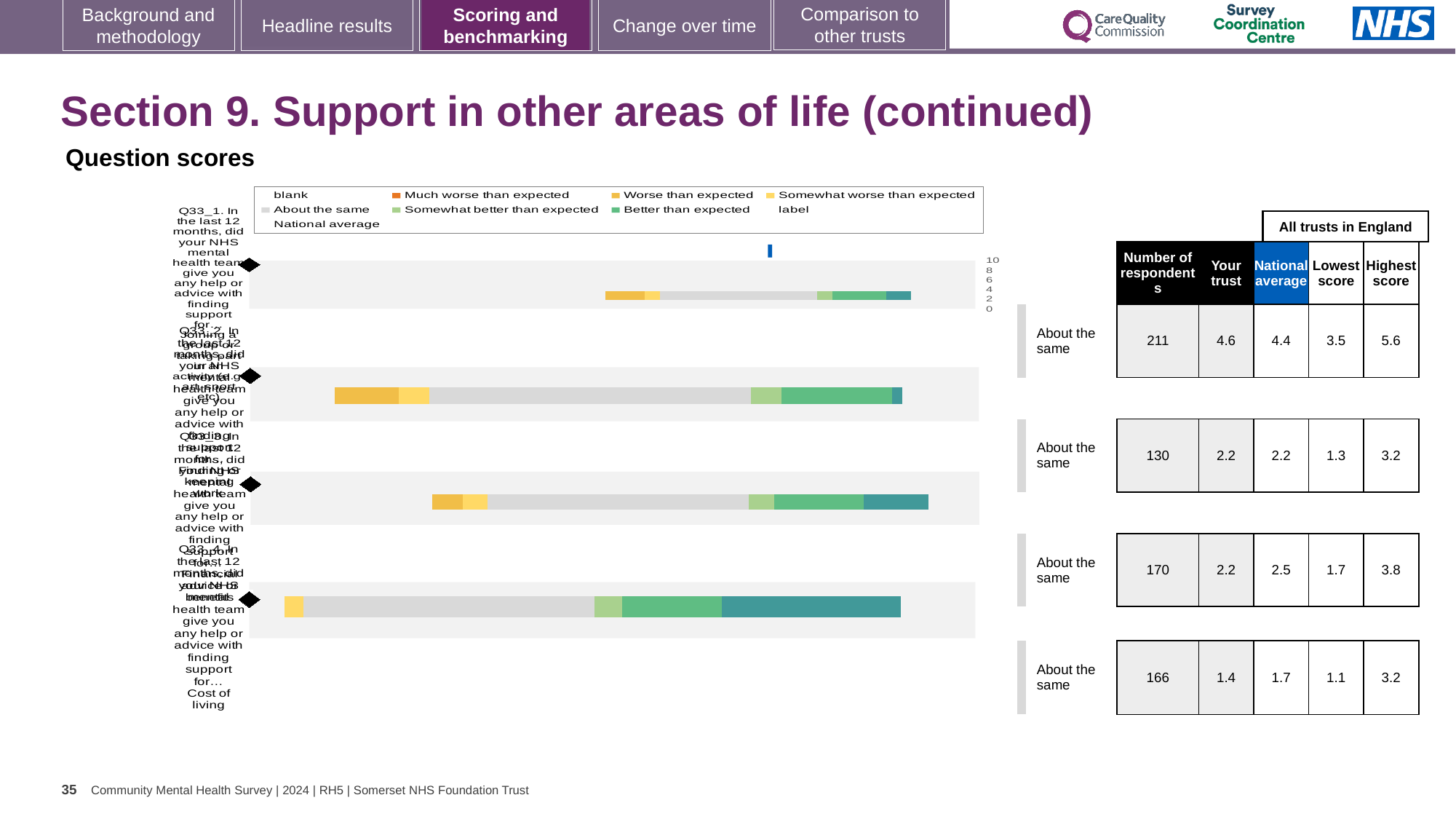
What benchmark label is shown next to each bar in the chart? About the same Which legend entry is shown in light grey? About the same Which legend entry is shown in dark orange? Much worse than expected In the table beside the chart, which row has the highest 'Your trust' score? The first row (Q33_1), 4.6 In the table beside the chart, what is the national average for the last row (Cost of living)? 1.7 What kind of chart is shown under 'Question scores'? Stacked bar chart How many horizontal bars (questions) are plotted in the chart? 4 In the table beside the chart, what is the number of respondents for the first row (Q33_1)? 211 In the table beside the chart, what is the 'Your trust' score for the first row (Q33_1)? 4.6 In the table beside the chart, which row has the lowest 'Your trust' score? The last row (Cost of living), 1.4 How many entries does the chart legend list? 9 In the table beside the chart, what is the difference between the highest score and lowest score for the first row (Q33_1)? 2.1